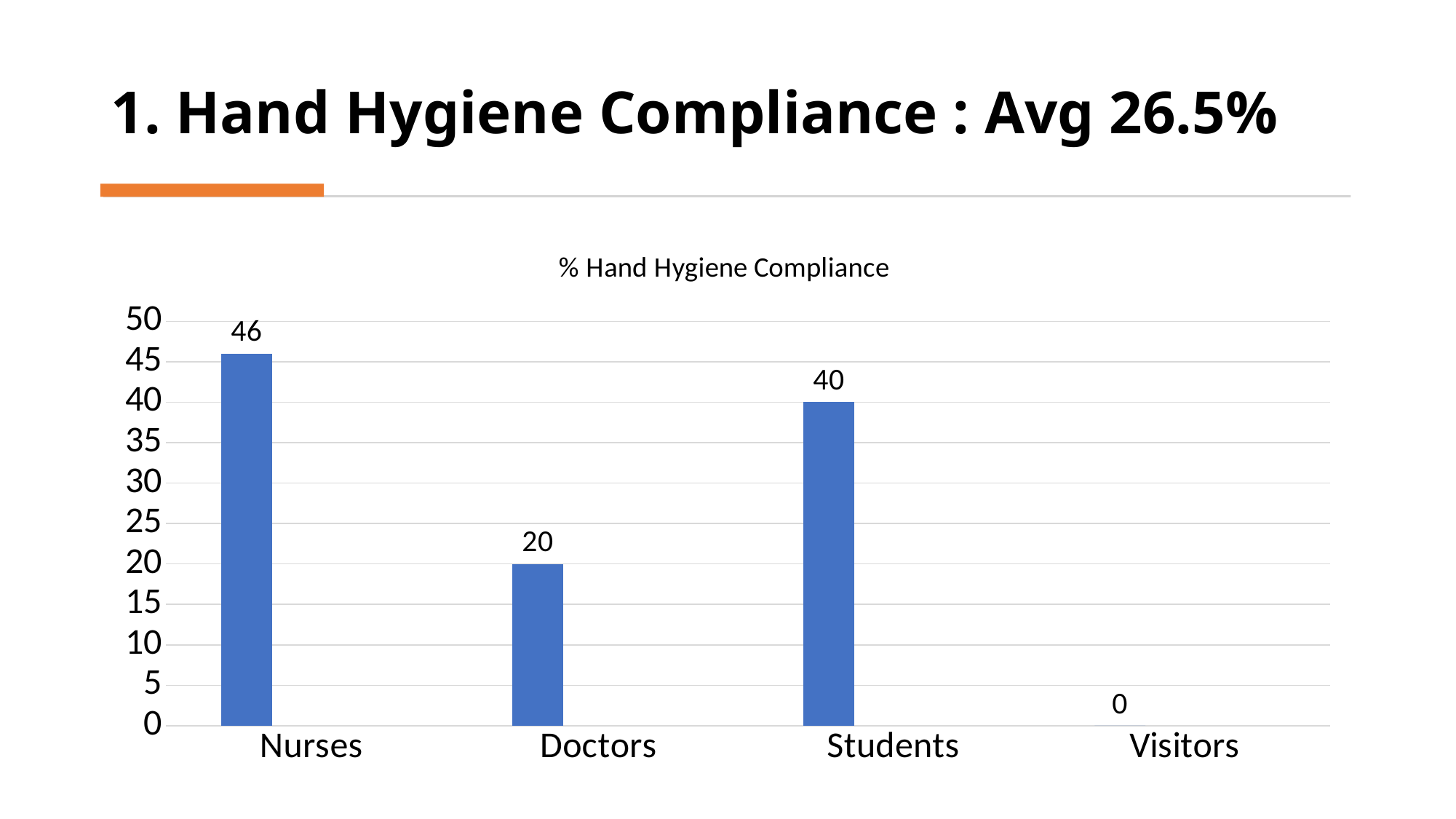
Which category has the highest hand hygiene compliance? Nurses What is the title of the chart? % Hand Hygiene Compliance What is the % Hand Hygiene Compliance value for Visitors? 0 What is the % Hand Hygiene Compliance value for Doctors? 20 What is the % Hand Hygiene Compliance value for Nurses? 46 Which has a higher compliance value, Doctors or Students? Students What is the difference between the compliance values for Nurses and Doctors? 26 Which category has the lowest hand hygiene compliance? Visitors How many categories are shown on the x axis of the chart? 4 What is the difference between the compliance values for Nurses and Students? 6 What type of chart is shown on the slide? Bar chart What is the % Hand Hygiene Compliance value for Students? 40